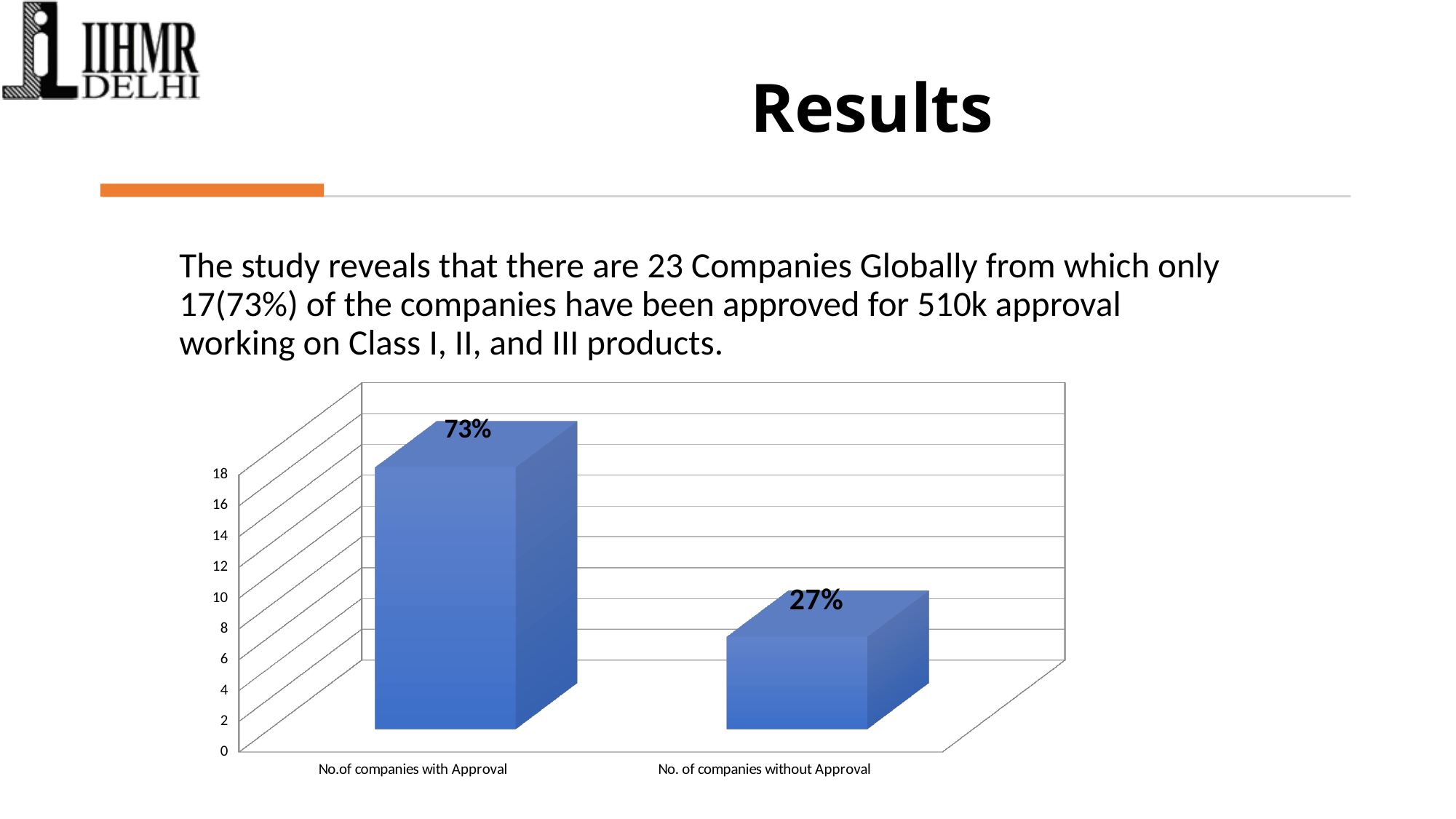
What is the difference between the data labels for No.of companies with Approval and No. of companies without Approval? 46% Is the value for No. of companies without Approval greater or less than 10? less What data label is shown on the bar for No. of companies without Approval? 27% What kind of chart is shown on the slide? Bar chart How many categories are shown on the chart? 2 What data label is shown on the bar for No.of companies with Approval? 73% Which is larger: the bar for No.of companies with Approval or the bar for No. of companies without Approval? No.of companies with Approval Is the value for No.of companies with Approval greater or less than 10? greater Which category has the highest bar? No.of companies with Approval What is the highest value shown on the vertical axis of the chart? 18 Do the bars rise or fall from left to right along the x axis? Fall Which category has the lowest bar? No. of companies without Approval